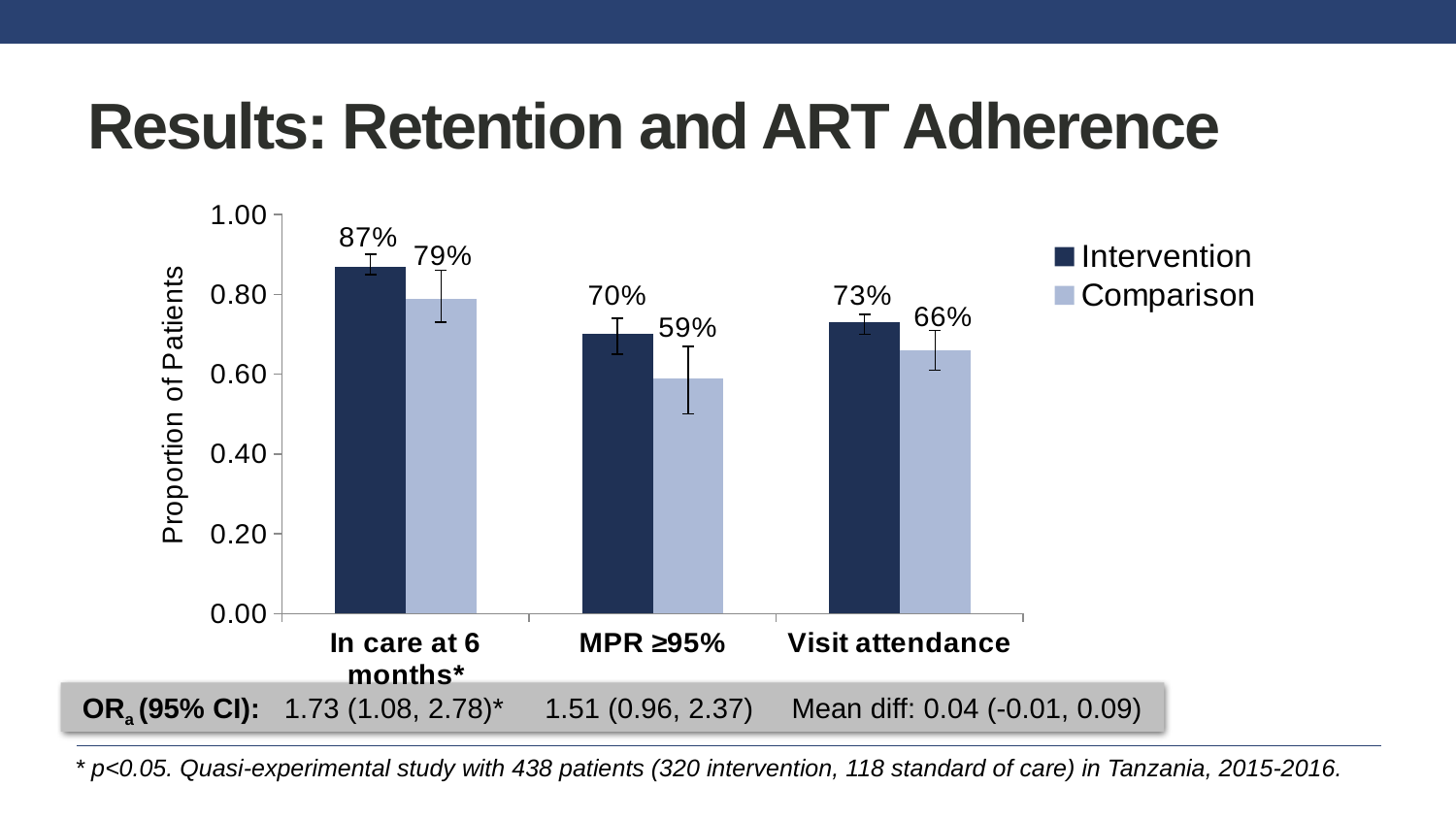
What is the difference between the Intervention and Comparison values for 'MPR ≥95%'? 11% What kind of chart is shown on the slide? Bar chart What is the difference between the Intervention and Comparison values for 'In care at 6 months*'? 8% Which is larger for 'Visit attendance': the Intervention value or the Comparison value? Intervention What is the Comparison value for 'MPR ≥95%'? 59% How many categories are shown on the x axis? 3 What is the label of the y axis? Proportion of Patients Which category has the lowest Comparison value? MPR ≥95% What is the Intervention value for 'In care at 6 months*'? 87% How many series does the legend list? 2 Which category has the highest Intervention value? In care at 6 months* What is the Comparison value for 'Visit attendance'? 66%